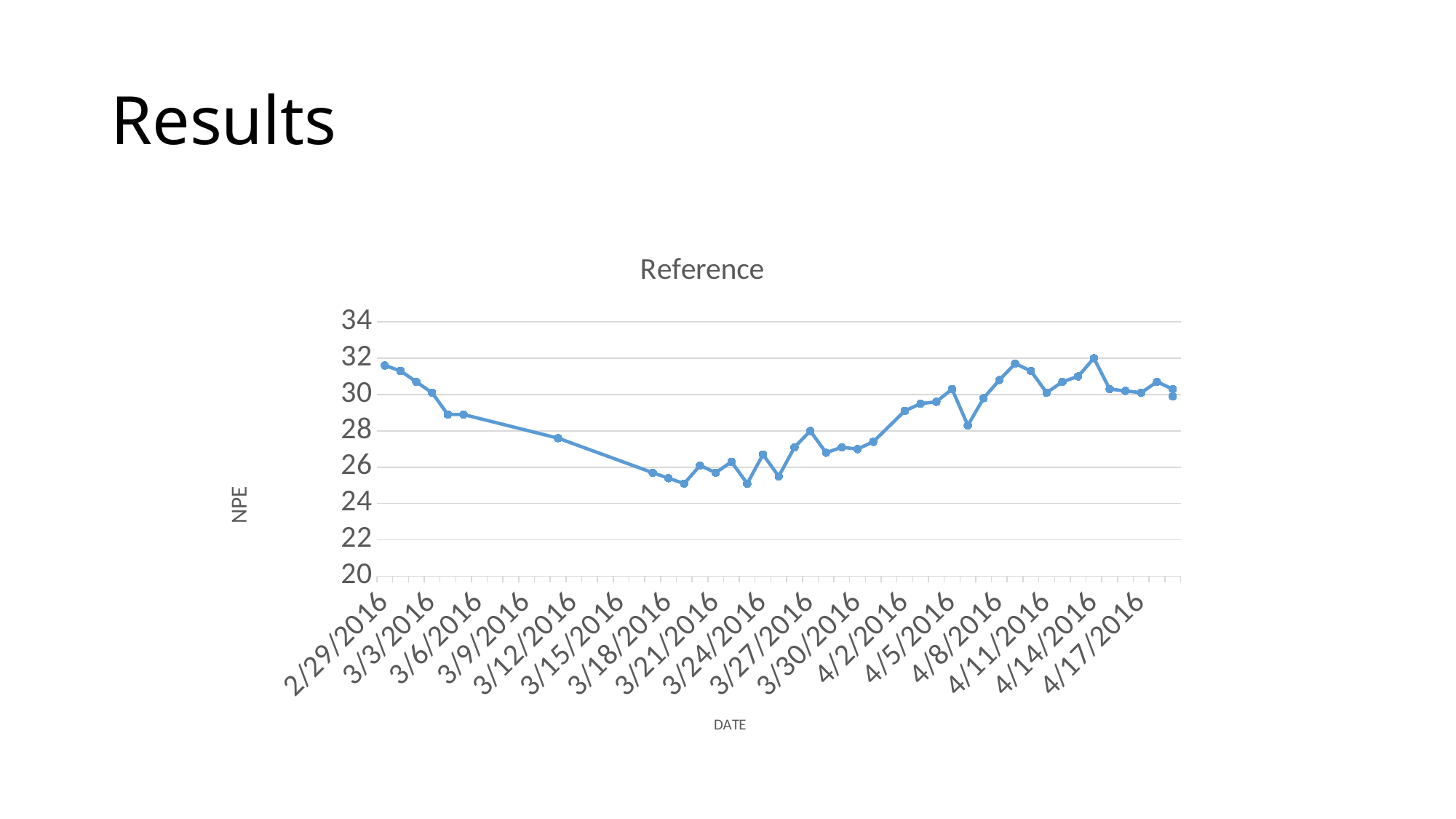
What kind of chart is shown on the slide? line chart Which has the higher value, 2/29/2016 or 3/21/2016? 2/29/2016 Is the value for 3/18/2016 greater or less than 26? less Do the values rise or fall from 2/29/2016 to 3/18/2016? fall What is the label on the vertical axis of the chart? NPE Is the value for 4/2/2016 greater or less than 28? greater Is the value for 4/14/2016 greater or less than 30? greater What is the title of the chart? Reference Do the values rise or fall from 3/24/2016 to 4/5/2016? rise Which has the higher value, 4/14/2016 or 3/24/2016? 4/14/2016